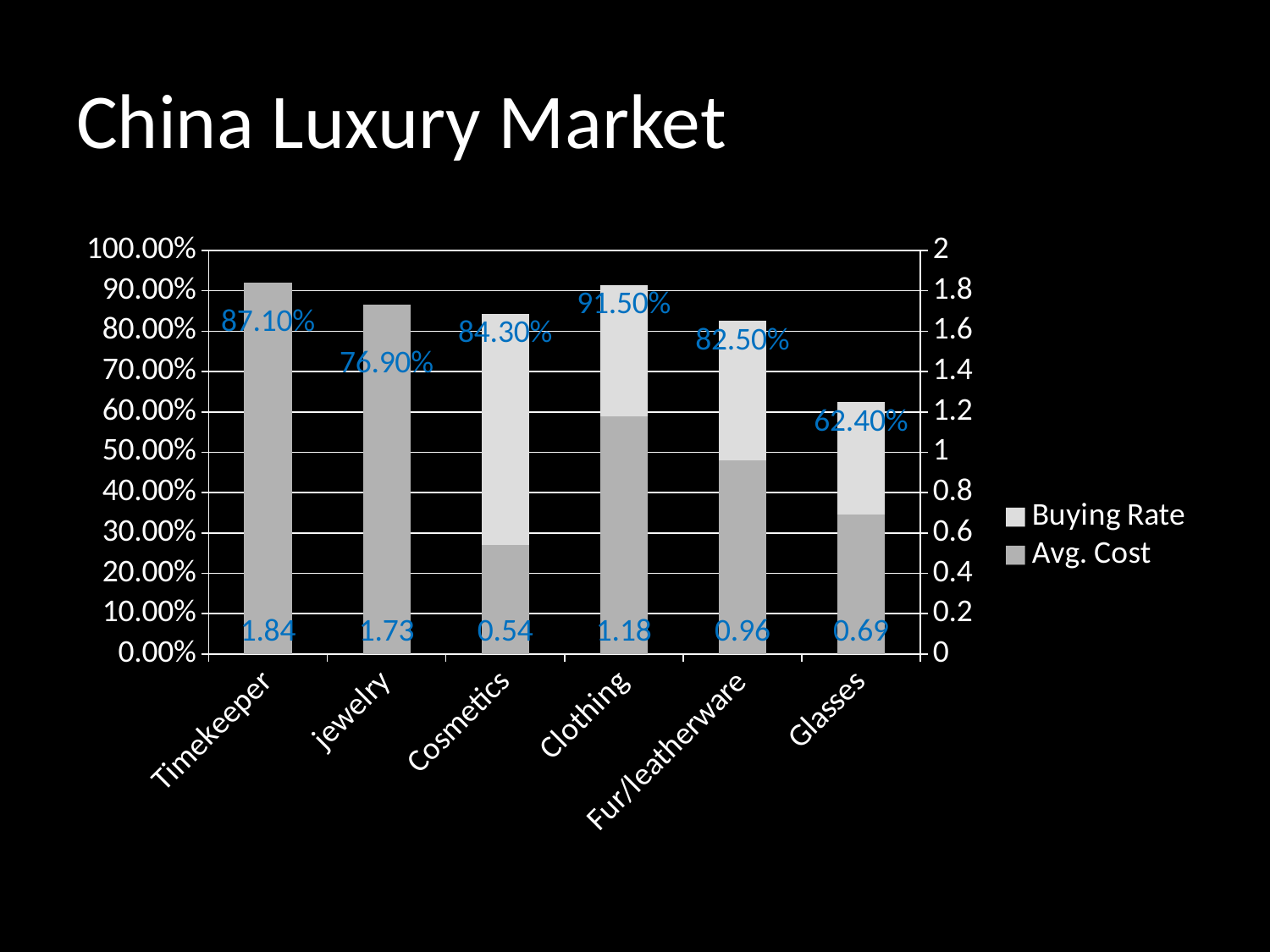
How many categories are shown on the x axis? 6 What is the Buying Rate for Glasses? 62.40% What is the Avg. Cost value for Timekeeper? 1.84 What is the difference in Avg. Cost between Timekeeper and Jewelry? 0.11 What is the Buying Rate for Clothing? 91.50% What is the Avg. Cost value for Cosmetics? 0.54 Which has a higher Avg. Cost, Clothing or Fur/leatherware? Clothing Which category has the lowest Avg. Cost? Cosmetics Which category has the highest Buying Rate? Clothing Which category has the lowest Buying Rate? Glasses What is the difference in Buying Rate between Clothing and Glasses? 29.10% How many series does the legend list? 2